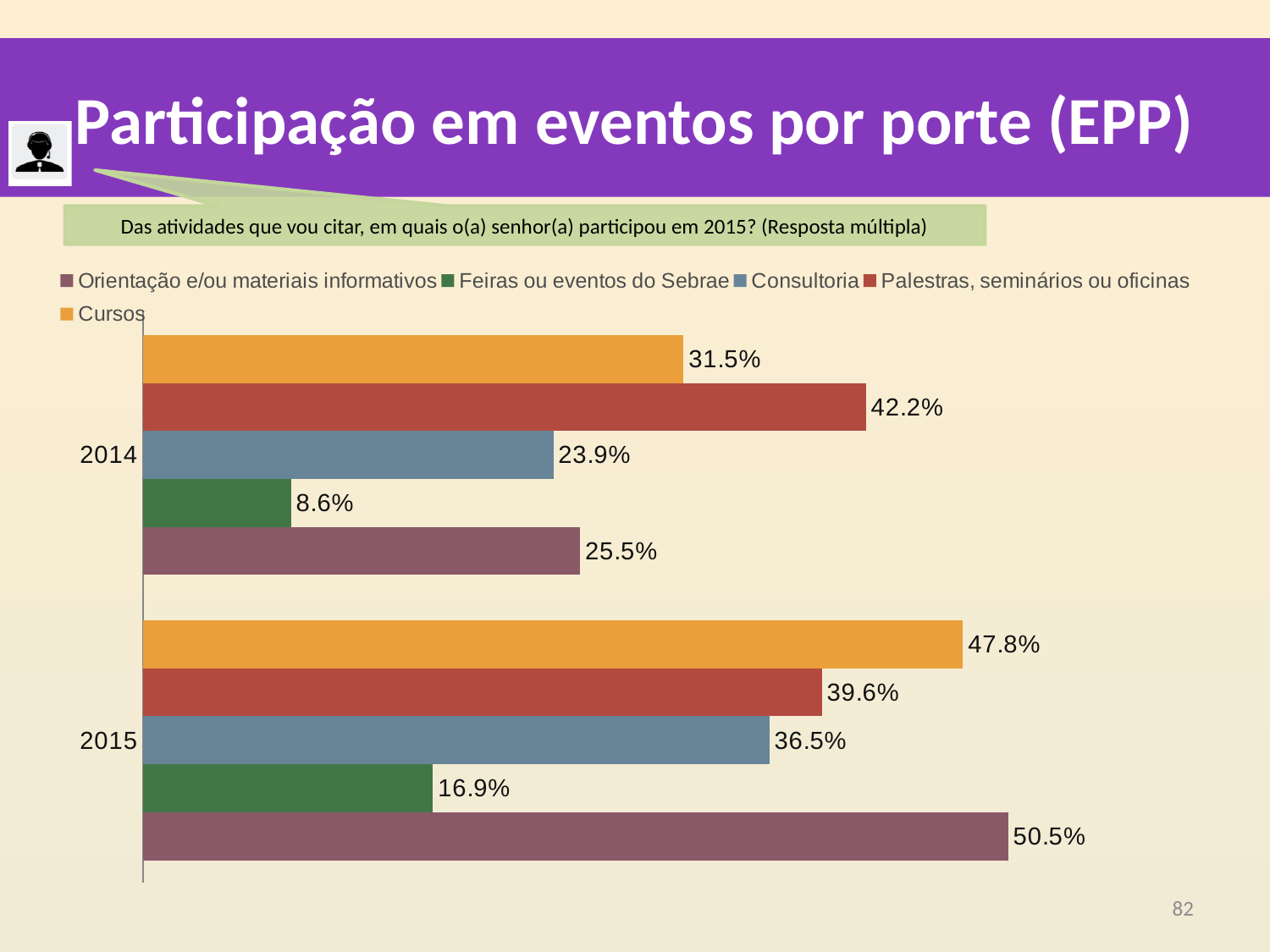
Which series has the highest value in 2014? Palestras, seminários ou oficinas How many series does the legend list? 5 What is the difference between the Orientação e/ou materiais informativos values for 2015 and 2014? 25.0% What colour are the bars for Cursos? orange What kind of chart is shown on the slide? bar chart How many year categories are shown on the chart? 2 What is the value for Feiras ou eventos do Sebrae in 2015? 16.9% Does the value for Consultoria rise or fall from 2014 to 2015? rise Which is larger: Palestras, seminários ou oficinas in 2014 or in 2015? 2014 What is the value for Consultoria in 2014? 23.9% Which series has the lowest value in 2015? Feiras ou eventos do Sebrae What is the value for Cursos in 2015? 47.8%